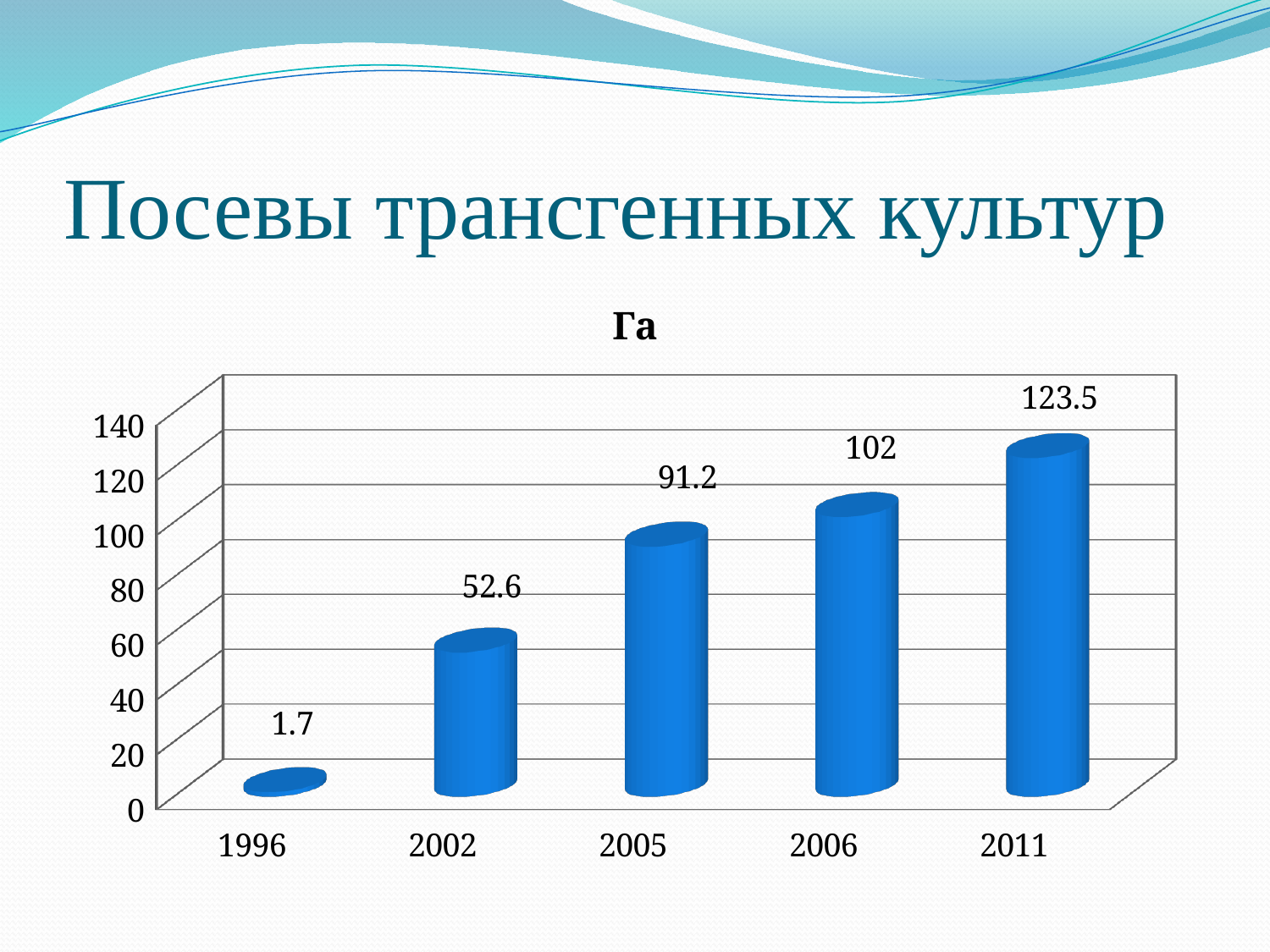
What kind of chart is shown on the slide? bar chart What is the difference between the values for 2011 and 2006? 21.5 What is the difference between the values for 2002 and 1996? 50.9 Which is larger, the value for 2002 or the value for 2005? 2005 Which year has the lowest value? 1996 What is the value for 2005? 91.2 What is the value for 2011? 123.5 Do the values rise or fall from 1996 to 2011? rise Which year has the highest value? 2011 Is the value for 2006 greater or less than 80? greater How many years are shown on the x axis? 5 What is the value for 1996? 1.7